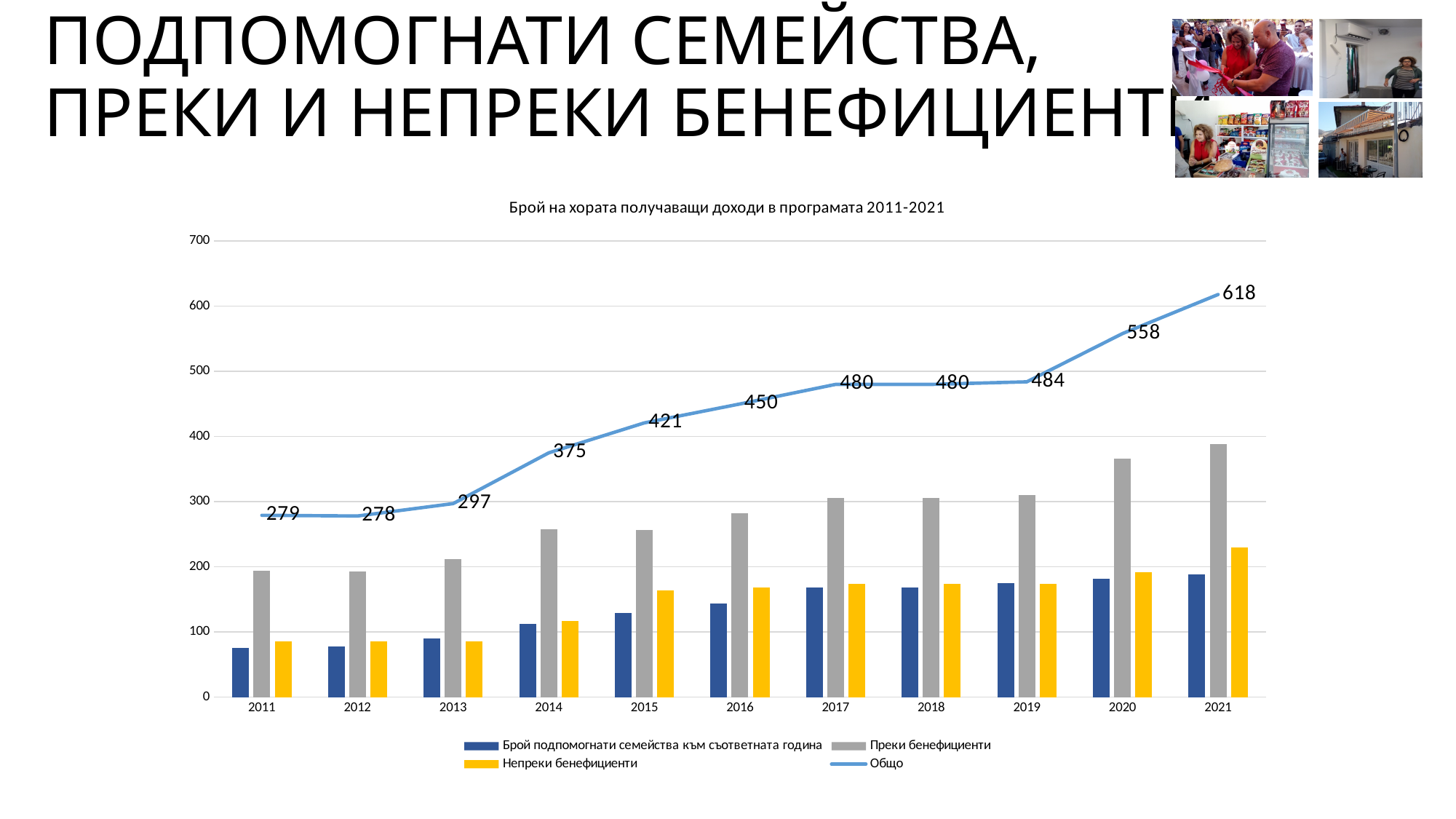
What is the value of the Общо line for 2021? 618 What is the difference between the Общо values for 2014 and 2013? 78 How many series does the legend list? 4 Is the value of the Преки бенефициенти bar for 2021 greater or less than 300? greater Is the value of the Непреки бенефициенти bar for 2011 greater or less than 100? less What is the value of the Общо line for 2012? 278 How many years are shown on the x axis? 11 In which year is the Общо line at its highest? 2021 What is the difference between the Общо values for 2021 and 2020? 60 In which year is the Общо line at its lowest? 2012 Is the Общо value for 2019 larger than the Общо value for 2016? Yes What is the value of the Общо line for 2014? 375